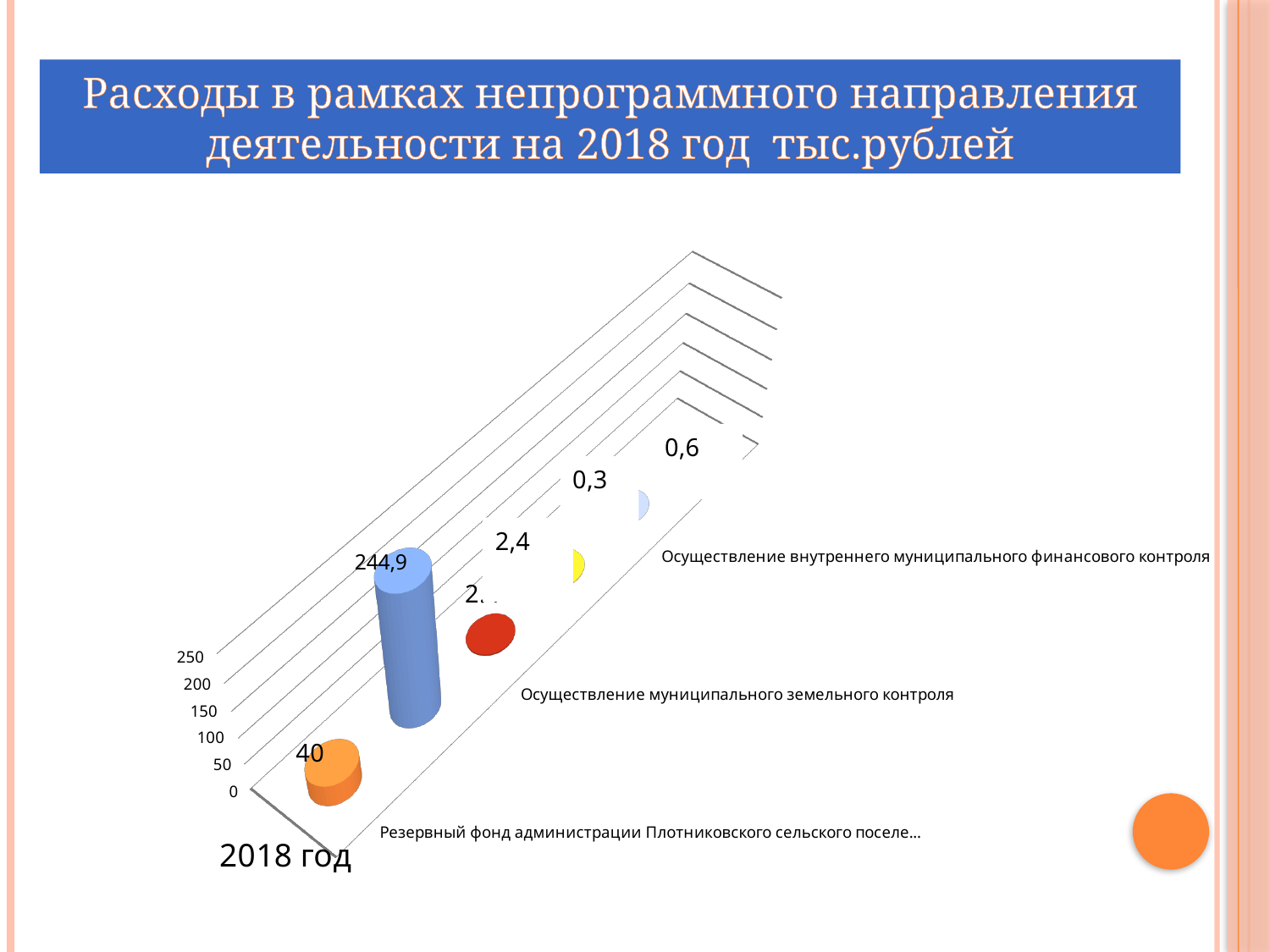
Is the value for Резервный фонд greater or less than 50? less What is the lowest value labelled on the chart? 0,3 Is the tallest bar's value greater or less than 200? greater What kind of chart is shown on the slide? bar chart What is the difference between the values labelled 2,4 and 0,3? 2,1 What year is shown as the category on the chart's horizontal axis? 2018 год How many data labels are printed on the chart? 6 What is the highest value labelled on the chart? 244,9 What is the value for Резервный фонд администрации Плотниковского сельского поселения? 40 What is the highest tick value shown on the vertical axis? 250 What is the difference between the highest labelled value (244,9) and the value for Резервный фонд (40)? 204,9 Which is larger, the value labelled 2,4 or the value labelled 0,6? 2,4